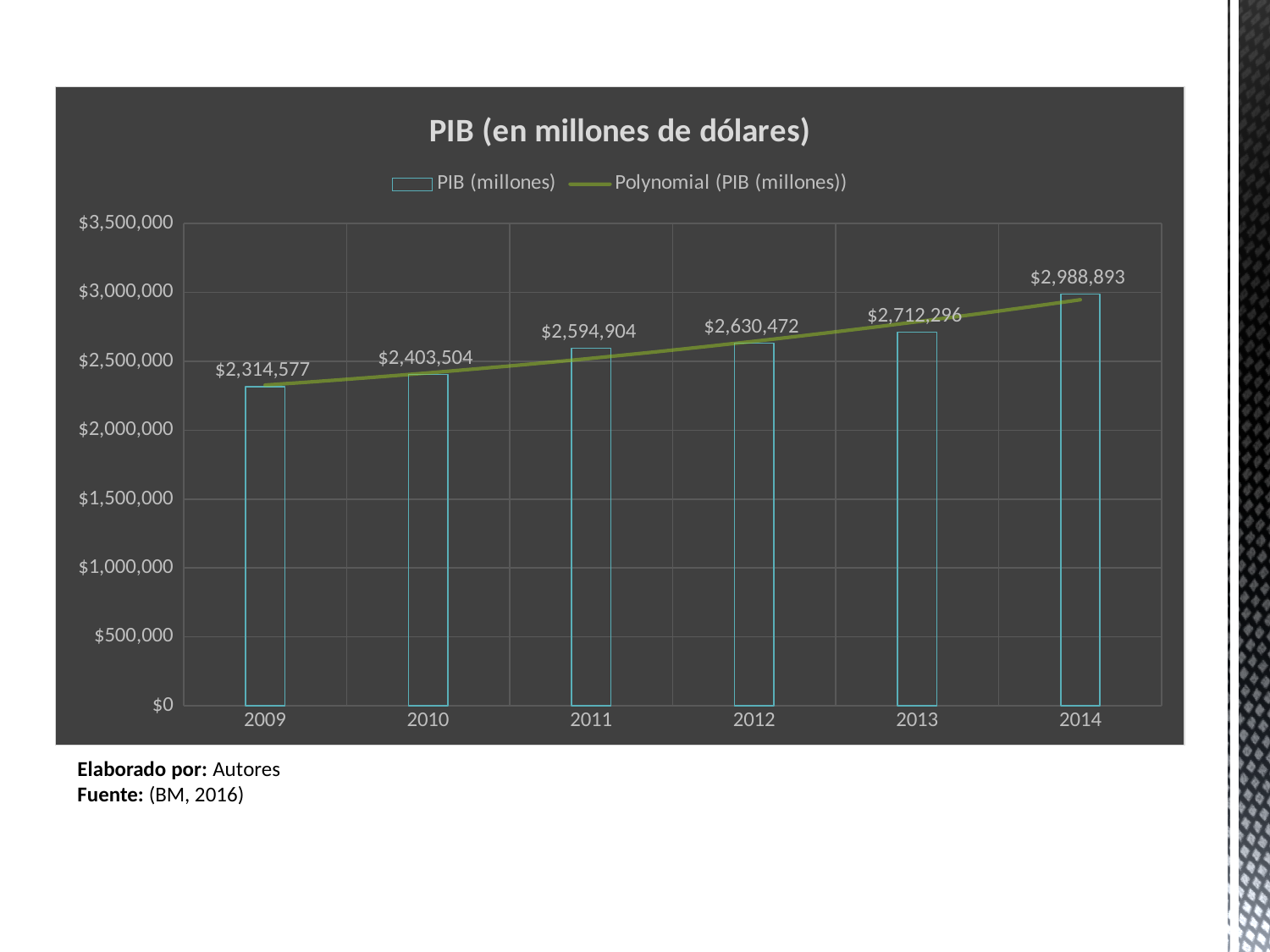
Which year has the highest PIB value? 2014 What is the PIB value for 2014? $2,988,893 Is the PIB value for 2013 greater or less than $3,000,000? less What is the PIB value for 2012? $2,630,472 Which year has a larger PIB value, 2011 or 2013? 2013 How many years are shown on the x axis? 6 What is the difference between the PIB values for 2011 and 2010? $191,400 What is the difference between the PIB values for 2014 and 2009? $674,316 How many entries does the legend list? 2 What is the PIB value for 2009? $2,314,577 Which year has the lowest PIB value? 2009 Do the PIB values rise or fall from 2009 to 2014? rise